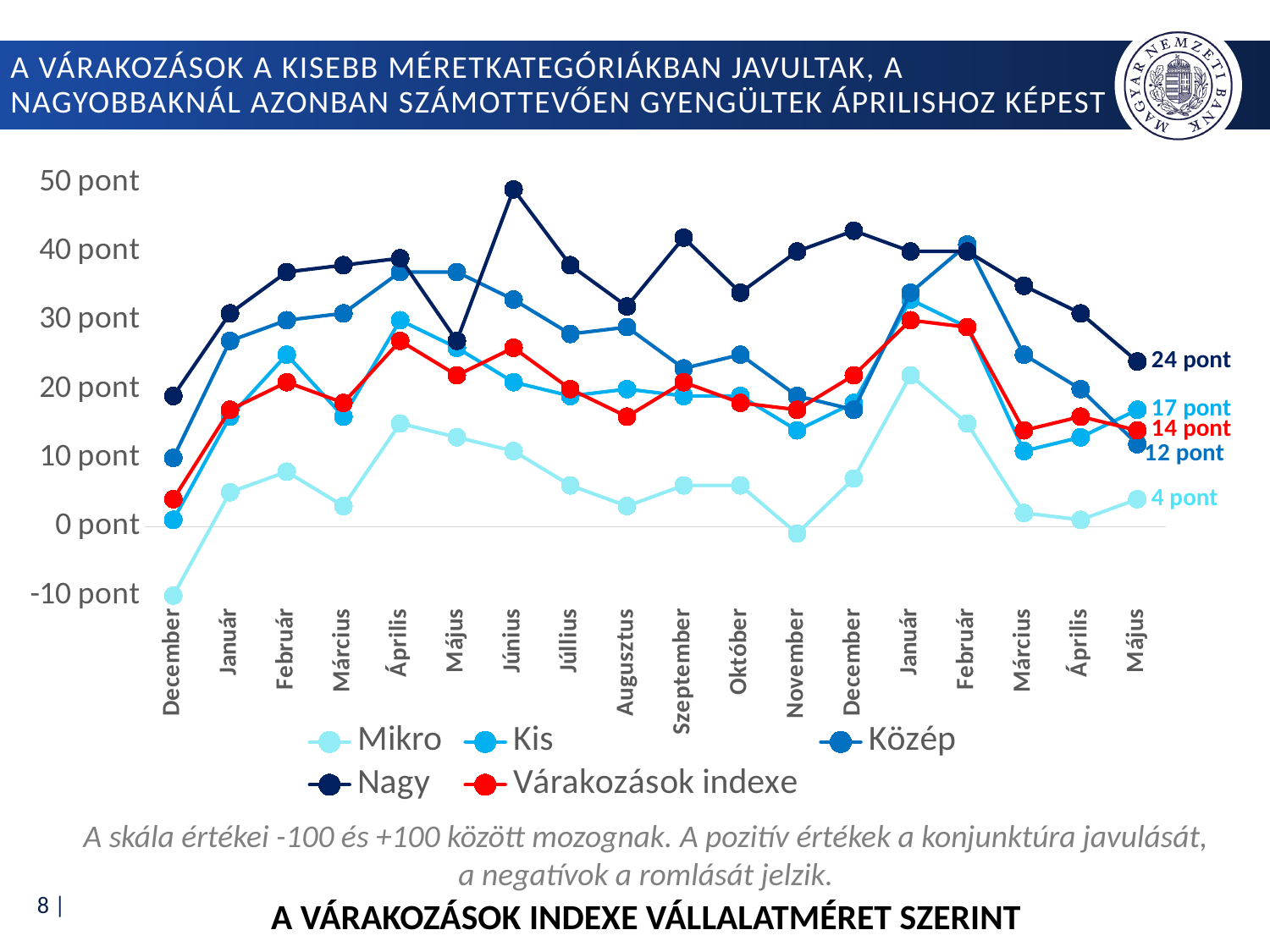
What is the value of the Várakozások indexe series at the final Május point? 14 pont What is the difference between the Nagy and Mikro values at the final Május point? 20 pont What is the value of the Kis series at the final Május point? 17 pont What is the value of the Közép series at the final Május point? 12 pont What is the value of the Mikro series at the final Május point? 4 pont How many time points are shown on the x axis? 18 What kind of chart is shown on the slide? line chart Which series has the lowest value at the final Május point? Mikro How many series does the legend list? 5 Which series has the highest value at the final Május point? Nagy Is the value for the Nagy series in Június greater or less than 40 pont? greater What is the value of the Nagy series at the final Május point? 24 pont